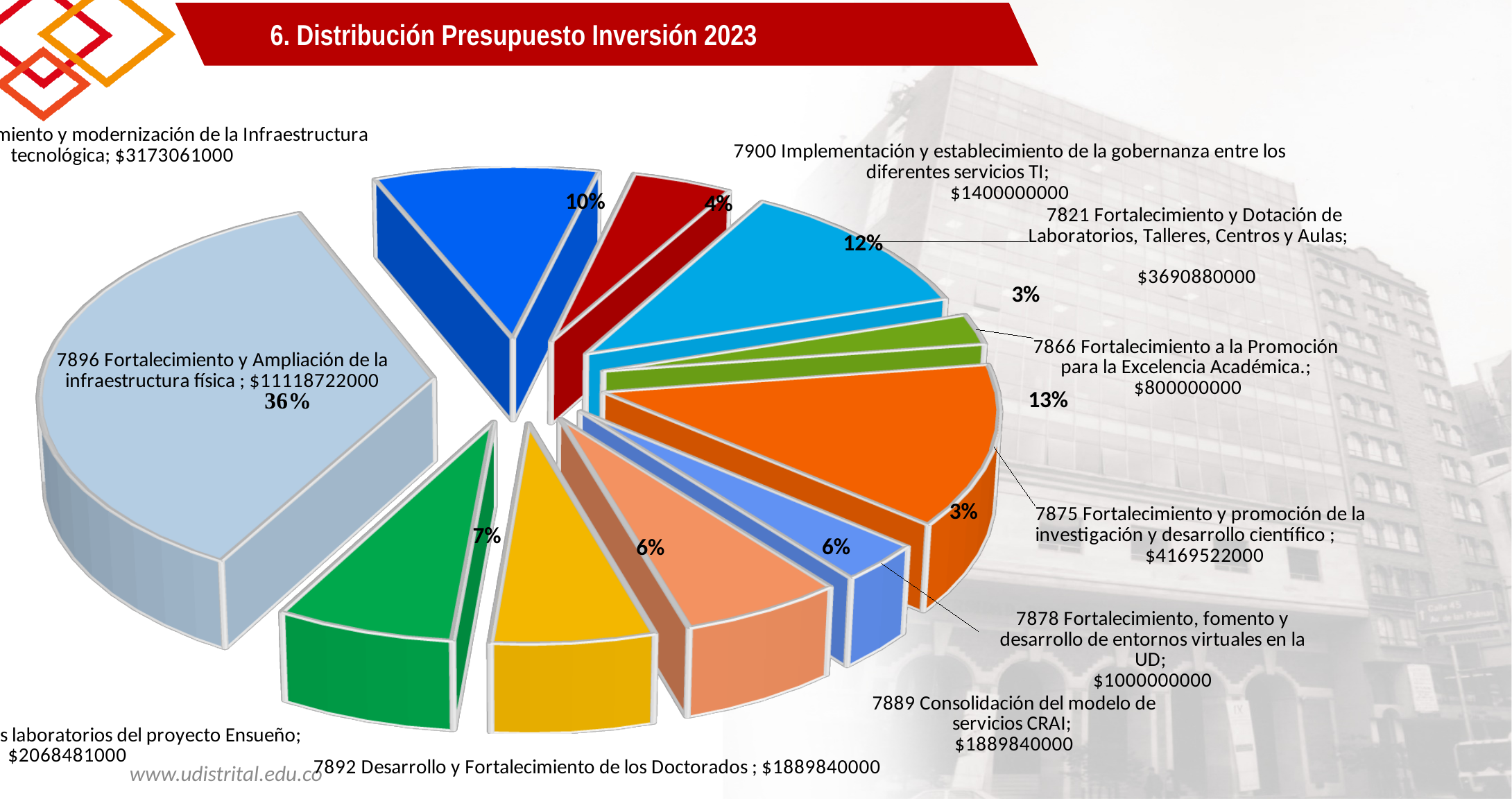
What kind of chart is shown on the slide? pie chart What share of the pie does 7896 Fortalecimiento y Ampliación de la infraestructura física represent? 36% What share of the pie does 7875 Fortalecimiento y promoción de la investigación y desarrollo científico represent? 13% What is the value for 7900 Implementación y establecimiento de la gobernanza entre los diferentes servicios TI? $1400000000 What is the value for 7866 Fortalecimiento a la Promoción para la Excelencia Académica? $800000000 What is the value for 7896 Fortalecimiento y Ampliación de la infraestructura física? $11118722000 What is the value for 7875 Fortalecimiento y promoción de la investigación y desarrollo científico? $4169522000 How many slices does the pie chart have? 10 Which category has the largest share of the pie? 7896 Fortalecimiento y Ampliación de la infraestructura física What is the difference between the values for 7875 Fortalecimiento y promoción de la investigación y desarrollo científico and 7821 Fortalecimiento y Dotación de Laboratorios, Talleres, Centros y Aulas? $478642000 What is the value for 7821 Fortalecimiento y Dotación de Laboratorios, Talleres, Centros y Aulas? $3690880000 What is the title of the slide's chart? 6. Distribución Presupuesto Inversión 2023